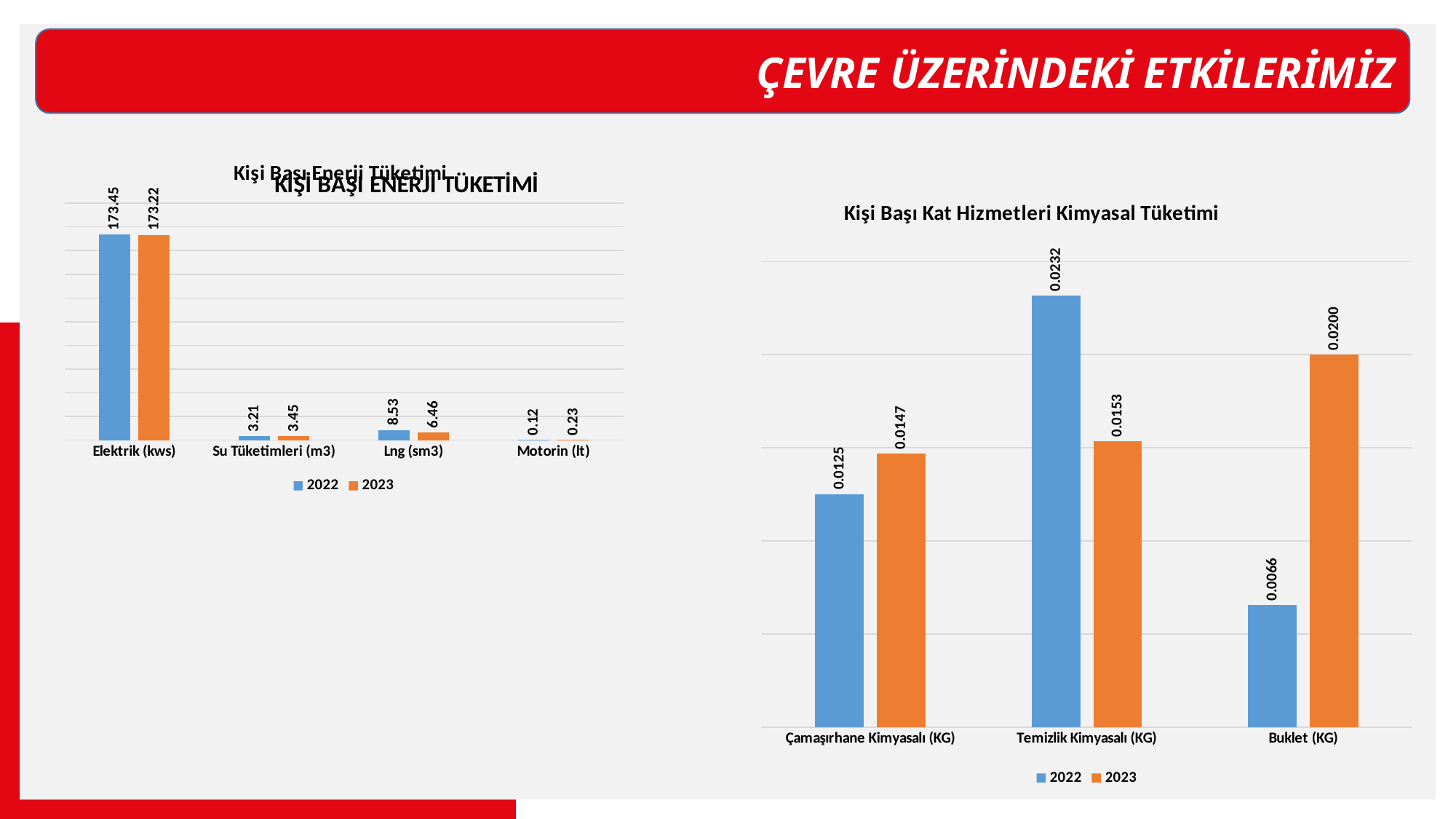
In the 'Kişi Başı Kat Hizmetleri Kimyasal Tüketimi' chart, is the 2022 or 2023 value larger for Çamaşırhane Kimyasalı (KG)? 2023 In the 'Kişi Başı Kat Hizmetleri Kimyasal Tüketimi' chart, which category has the lowest 2022 value? Buklet (KG) In the 'Kişi Başı Enerji Tüketimi' chart, which category has the highest 2022 value? Elektrik (kws) In the 'Kişi Başı Enerji Tüketimi' chart, what is the 2022 value for Elektrik (kws)? 173.45 In the 'Kişi Başı Kat Hizmetleri Kimyasal Tüketimi' chart, how many series does the legend list? 2 In the 'Kişi Başı Kat Hizmetleri Kimyasal Tüketimi' chart, what is the 2022 value for Temizlik Kimyasalı (KG)? 0.0232 In the 'Kişi Başı Enerji Tüketimi' chart, how many categories are shown on the x axis? 4 What type of chart is the 'Kişi Başı Kat Hizmetleri Kimyasal Tüketimi' chart? Bar chart In the 'Kişi Başı Kat Hizmetleri Kimyasal Tüketimi' chart, what is the 2023 value for Buklet (KG)? 0.0200 In the 'Kişi Başı Enerji Tüketimi' chart, what is the 2023 value for Lng (sm3)? 6.46 In the 'Kişi Başı Enerji Tüketimi' chart, what is the difference between the 2022 and 2023 values for Lng (sm3)? 2.07 In the 'Kişi Başı Enerji Tüketimi' chart, what is the 2023 value for Motorin (lt)? 0.23